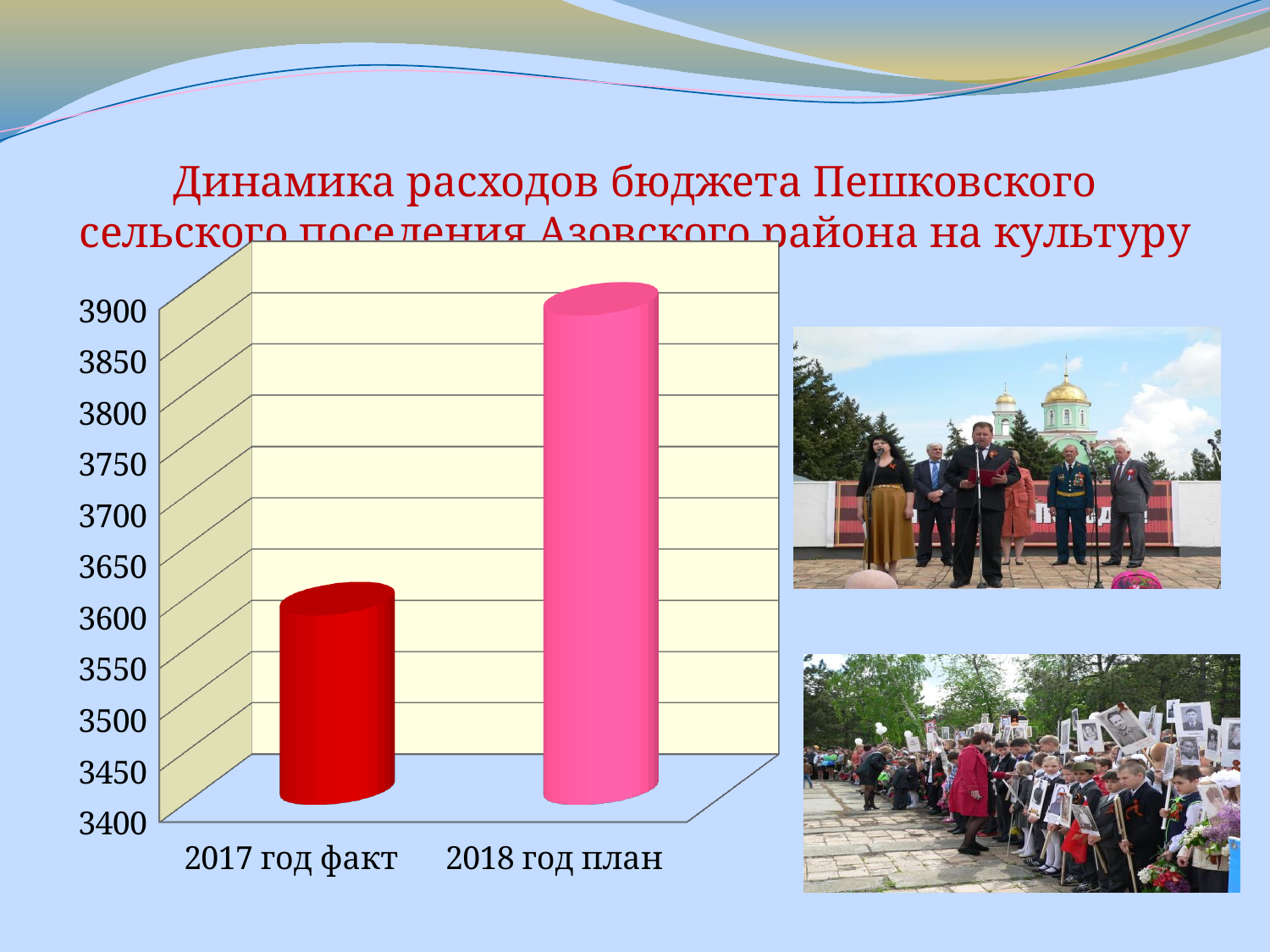
How many categories are plotted on the chart? 2 Do the values rise or fall from 2017 год факт to 2018 год план? rise Which category has the lowest value on the chart? 2017 год факт Is the value for 2018 год план greater or less than 3800? greater Which is larger, the value for 2017 год факт or the value for 2018 год план? 2018 год план What colour is the bar for 2018 год план? pink What kind of chart is shown on the slide? bar chart What is the lowest value shown on the vertical axis of the chart? 3400 Is the value for 2017 год факт greater or less than 3500? greater Is the value for 2017 год факт greater or less than 3700? less Which category has the highest value on the chart? 2018 год план